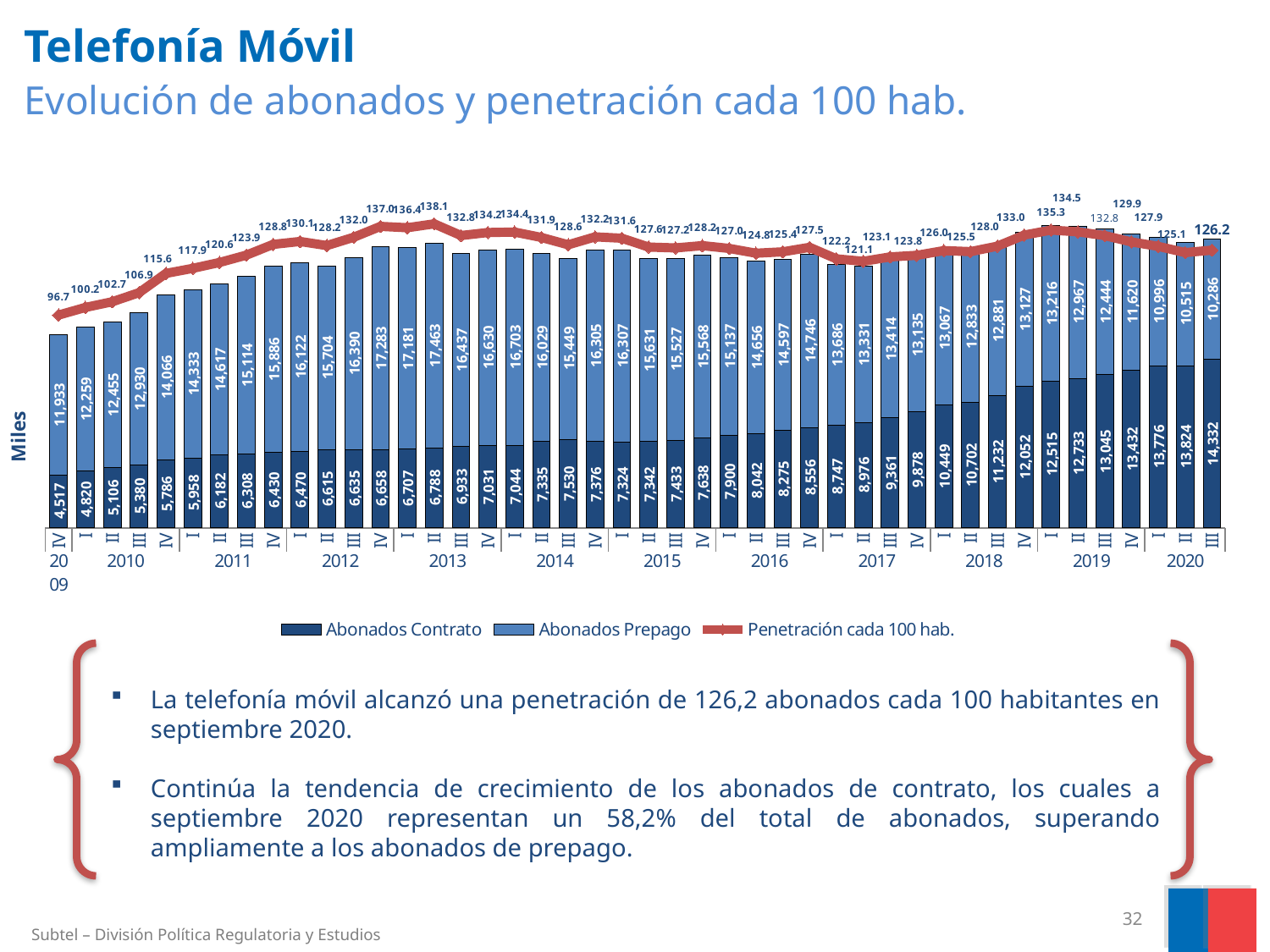
Does Abonados Contrato rise or fall from IV 2009 to III 2020? rise What is the Penetración cada 100 hab. value for III 2020? 126.2 What is the difference between Abonados Contrato and Abonados Prepago in III 2020? 4,046 In which quarter does Penetración cada 100 hab. reach its highest value? II 2013 Which is larger in IV 2009: Abonados Contrato or Abonados Prepago? Abonados Prepago What kind of chart is shown on the slide? Stacked bar chart with a line What is the total of Abonados Contrato and Abonados Prepago in III 2020? 24,618 How many series does the legend list? 3 What is the value of Abonados Contrato for III 2020? 14,332 In which quarter is Abonados Prepago highest? II 2013 What is the value of Abonados Prepago for IV 2009? 11,933 What is the lowest Penetración cada 100 hab. value shown on the chart? 96.7